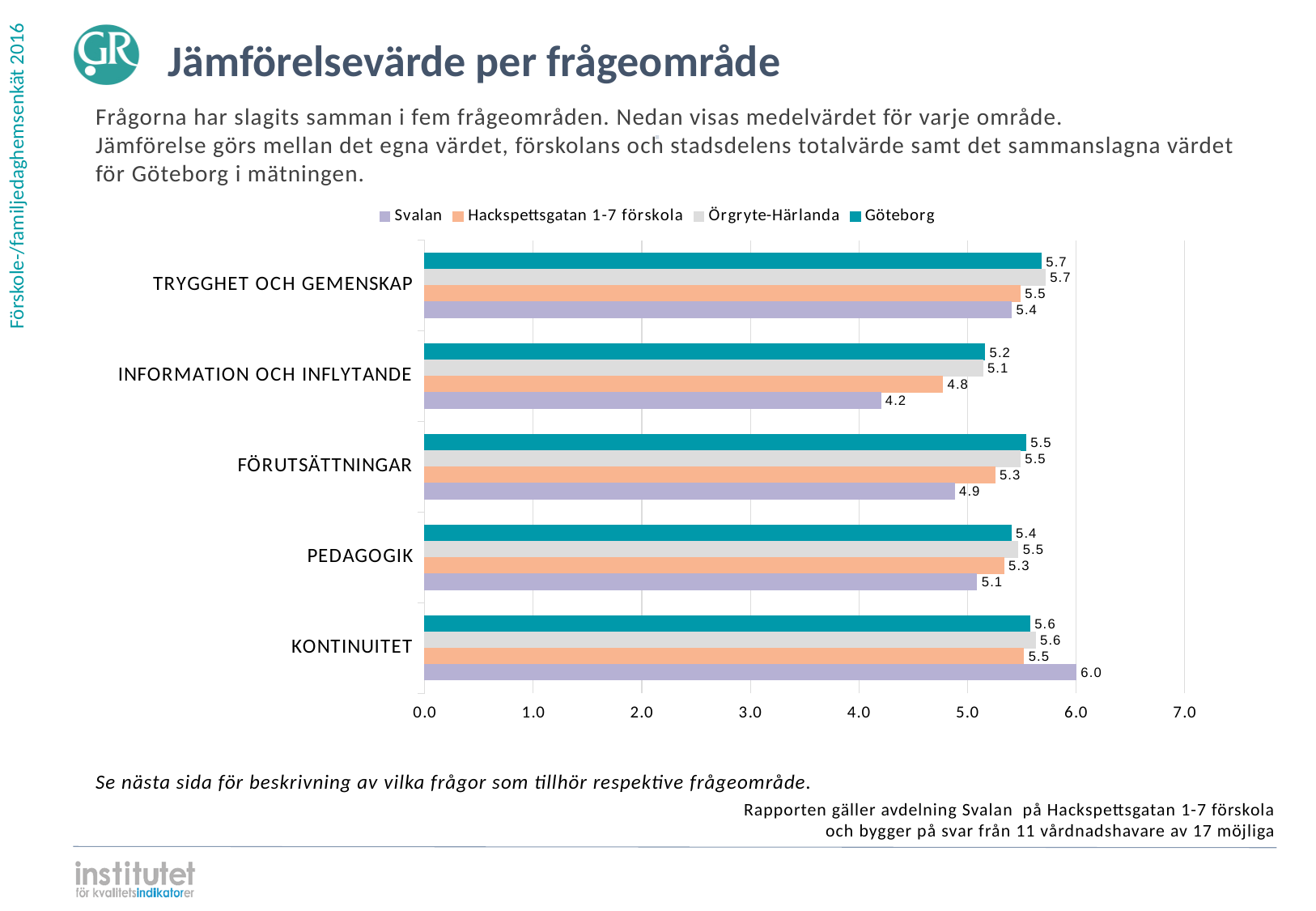
What is the value for Svalan in the KONTINUITET category? 6.0 How many categories are shown on the chart? 5 What is the value for Hackspettsgatan 1-7 förskola in the FÖRUTSÄTTNINGAR category? 5.3 In which category does Svalan have its lowest value? INFORMATION OCH INFLYTANDE Is the value for Svalan in the FÖRUTSÄTTNINGAR category greater or less than 5.0? less How many series does the legend list? 4 What is the difference between the Göteborg value and the Svalan value in the INFORMATION OCH INFLYTANDE category? 1.0 What is the value for Göteborg in the PEDAGOGIK category? 5.4 What is the value for Svalan in the INFORMATION OCH INFLYTANDE category? 4.2 In which category does Svalan have its highest value? KONTINUITET What kind of chart is shown on the slide? bar chart Which is larger in the KONTINUITET category: the value for Svalan or the value for Göteborg? Svalan